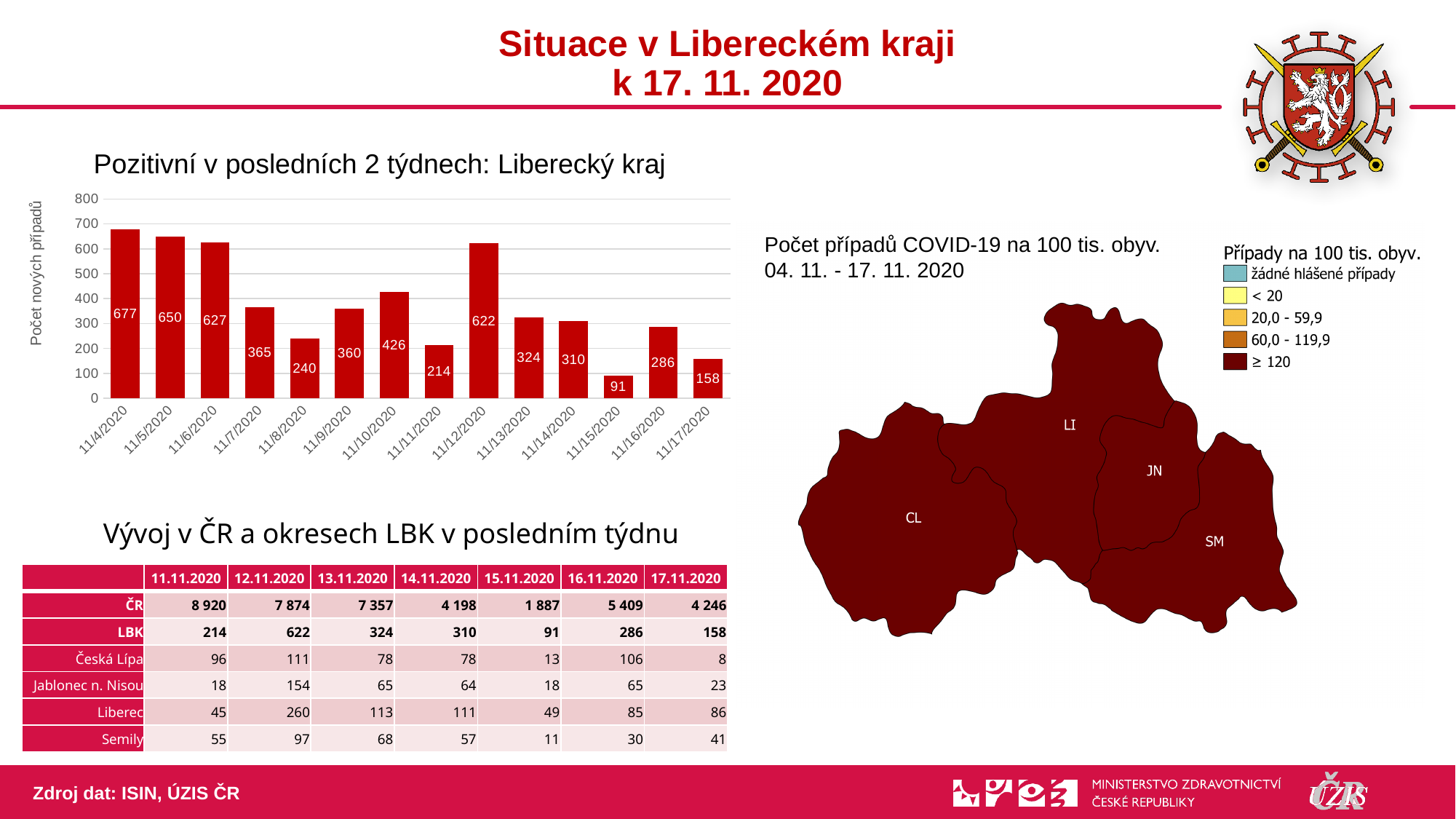
In the bar chart 'Pozitivní v posledních 2 týdnech: Liberecký kraj', is the value for 11/16/2020 greater or less than 300? less What kind of chart is 'Pozitivní v posledních 2 týdnech: Liberecký kraj'? bar chart In the bar chart 'Pozitivní v posledních 2 týdnech: Liberecký kraj', which is larger, the value for 11/7/2020 or 11/9/2020? 11/7/2020 In the bar chart 'Pozitivní v posledních 2 týdnech: Liberecký kraj', what is the value for 11/17/2020? 158 In the bar chart 'Pozitivní v posledních 2 týdnech: Liberecký kraj', what is the difference between the values for 11/4/2020 and 11/5/2020? 27 In the bar chart 'Pozitivní v posledních 2 týdnech: Liberecký kraj', what is the value for 11/12/2020? 622 In the bar chart 'Pozitivní v posledních 2 týdnech: Liberecký kraj', which date has the highest value? 11/4/2020 In the bar chart 'Pozitivní v posledních 2 týdnech: Liberecký kraj', what is the value for 11/10/2020? 426 What is the y-axis label of the bar chart 'Pozitivní v posledních 2 týdnech: Liberecký kraj'? Počet nových případů In the bar chart 'Pozitivní v posledních 2 týdnech: Liberecký kraj', what is the difference between the values for 11/12/2020 and 11/11/2020? 408 How many bars (dates) are shown in the bar chart 'Pozitivní v posledních 2 týdnech: Liberecký kraj'? 14 In the bar chart 'Pozitivní v posledních 2 týdnech: Liberecký kraj', which date has the lowest value? 11/15/2020